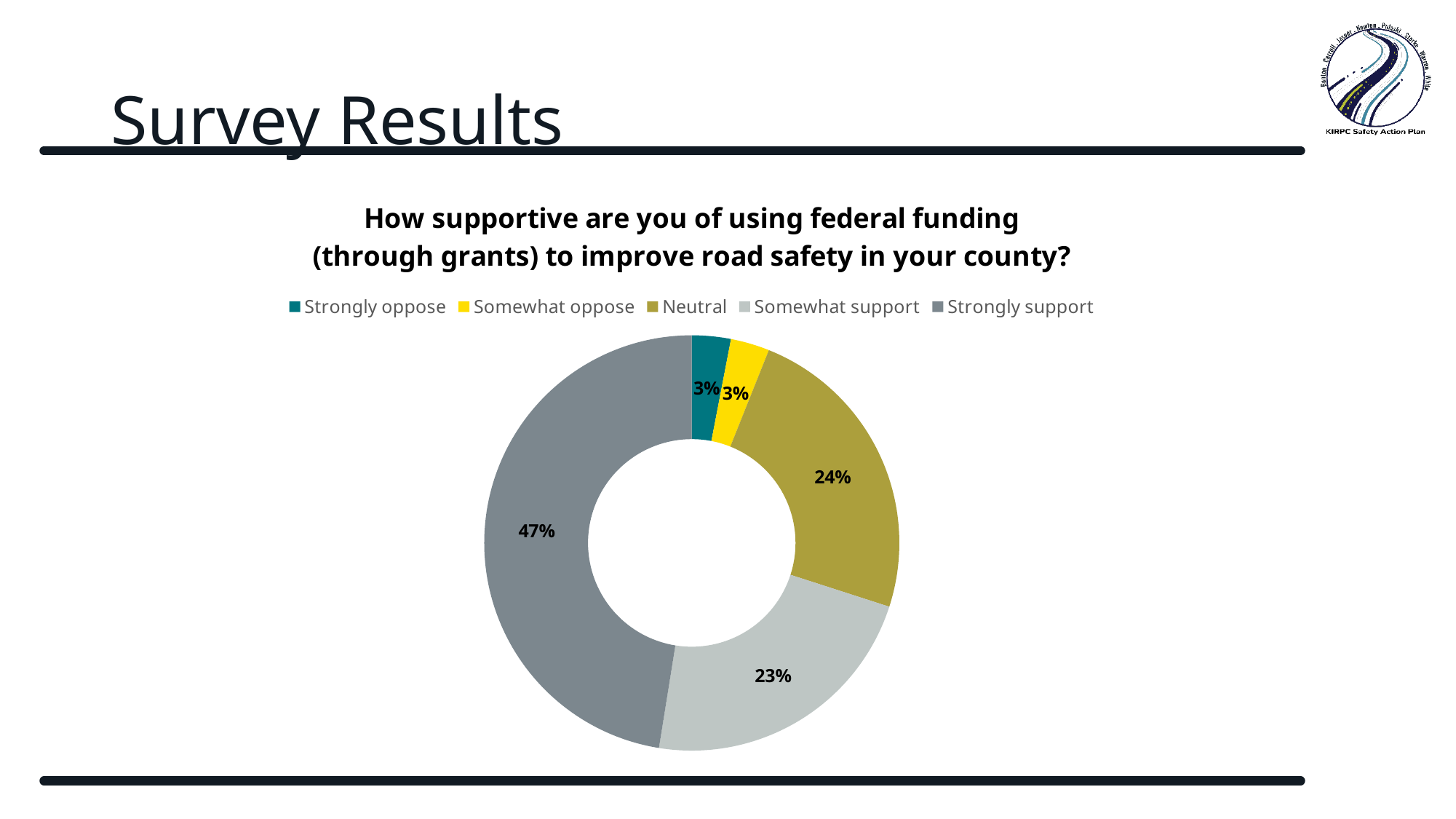
What share of respondents answered Neutral? 24% What is the title of the chart? How supportive are you of using federal funding (through grants) to improve road safety in your county? What share of respondents answered Somewhat support? 23% Which legend entry is shown in yellow? Somewhat oppose What share of respondents answered Strongly support? 47% What is the difference in percentage points between Strongly support and Somewhat support? 24 What share of respondents answered Strongly oppose? 3% What is the combined share of Strongly support and Somewhat support? 70% How many response categories does the chart show? 5 Which response category has the largest share? Strongly support What kind of chart is shown on the slide? Doughnut (pie) chart Which is larger, the share for Neutral or the share for Somewhat support? Neutral